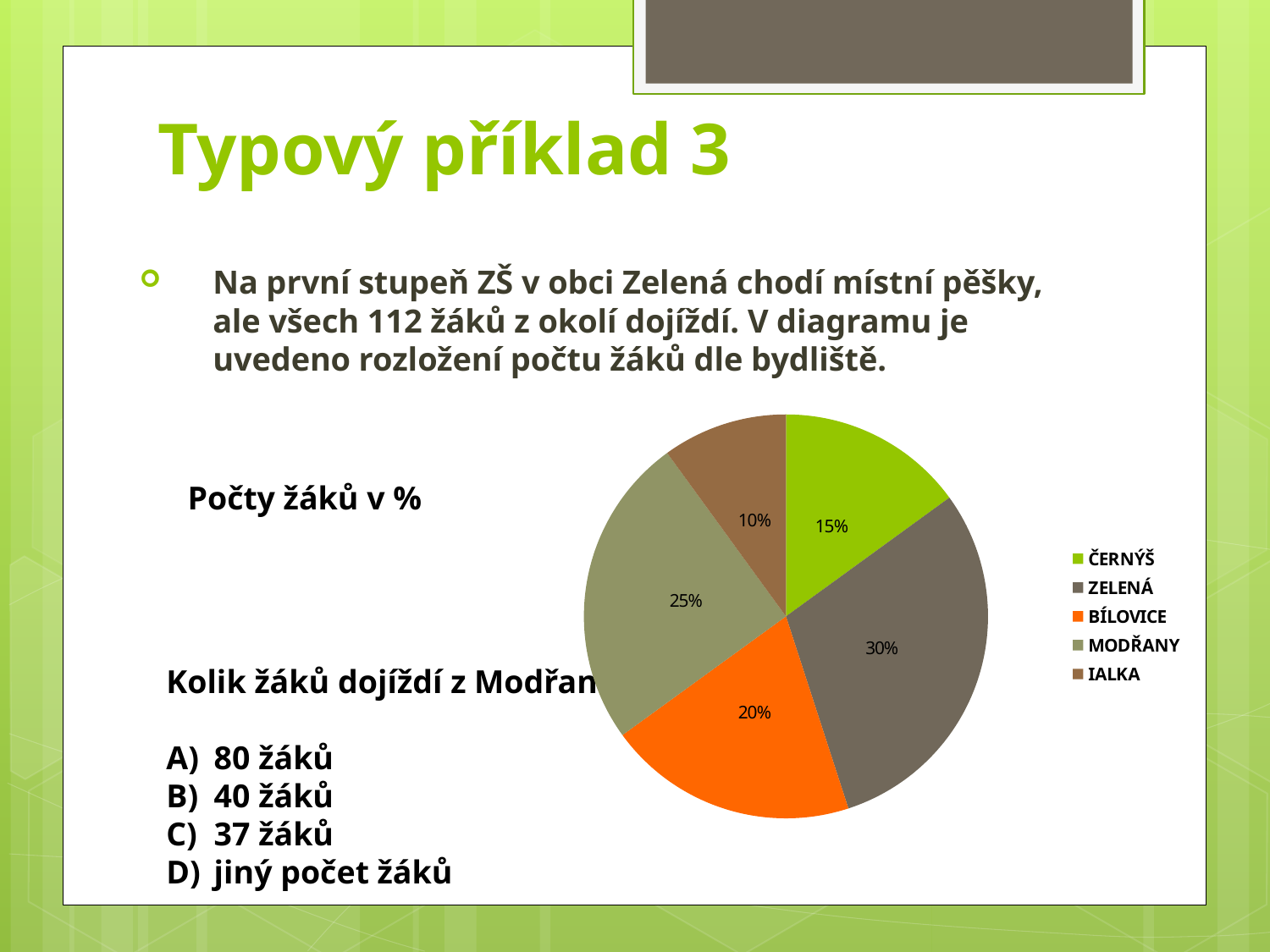
Which has a larger share, MODŘANY or BÍLOVICE? MODŘANY What is the title of the pie chart? Počty žáků v % What kind of chart is shown on the slide? pie chart What percentage of pupils come from ČERNÝŠ? 15% What percentage of pupils come from IALKA? 10% What percentage of pupils come from MODŘANY? 25% How many slices does the pie chart have? 5 What percentage of pupils come from ZELENÁ? 30% Which place has the smallest share of the pie? IALKA What is the difference in percentage points between ZELENÁ and ČERNÝŠ? 15 What percentage of pupils come from BÍLOVICE? 20% Which place has the largest share of the pie? ZELENÁ